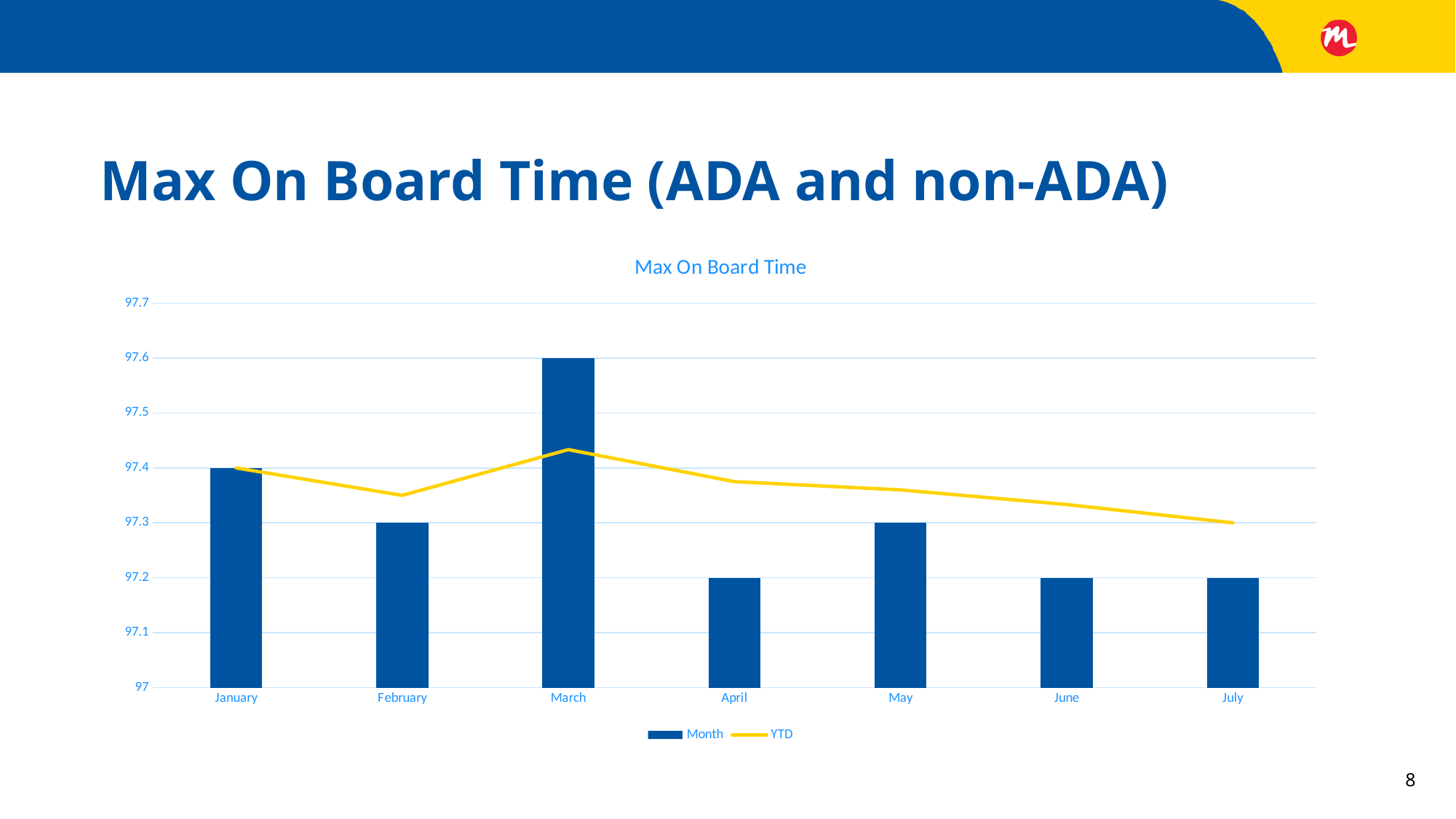
What is the title of the chart? Max On Board Time What is the Month value for April? 97.2 What is the Month value for January? 97.4 Does the YTD line rise or fall from March to July? fall What is the Month value for March? 97.6 Which is larger, the Month value for May or the Month value for June? May How many months are shown on the x axis? 7 What is the difference between the Month values for March and February? 0.3 How many series does the legend list? 2 Is the YTD value for April greater or less than 97.3? greater Is the YTD value for February greater or less than 97.4? less Which month has the highest Month bar? March